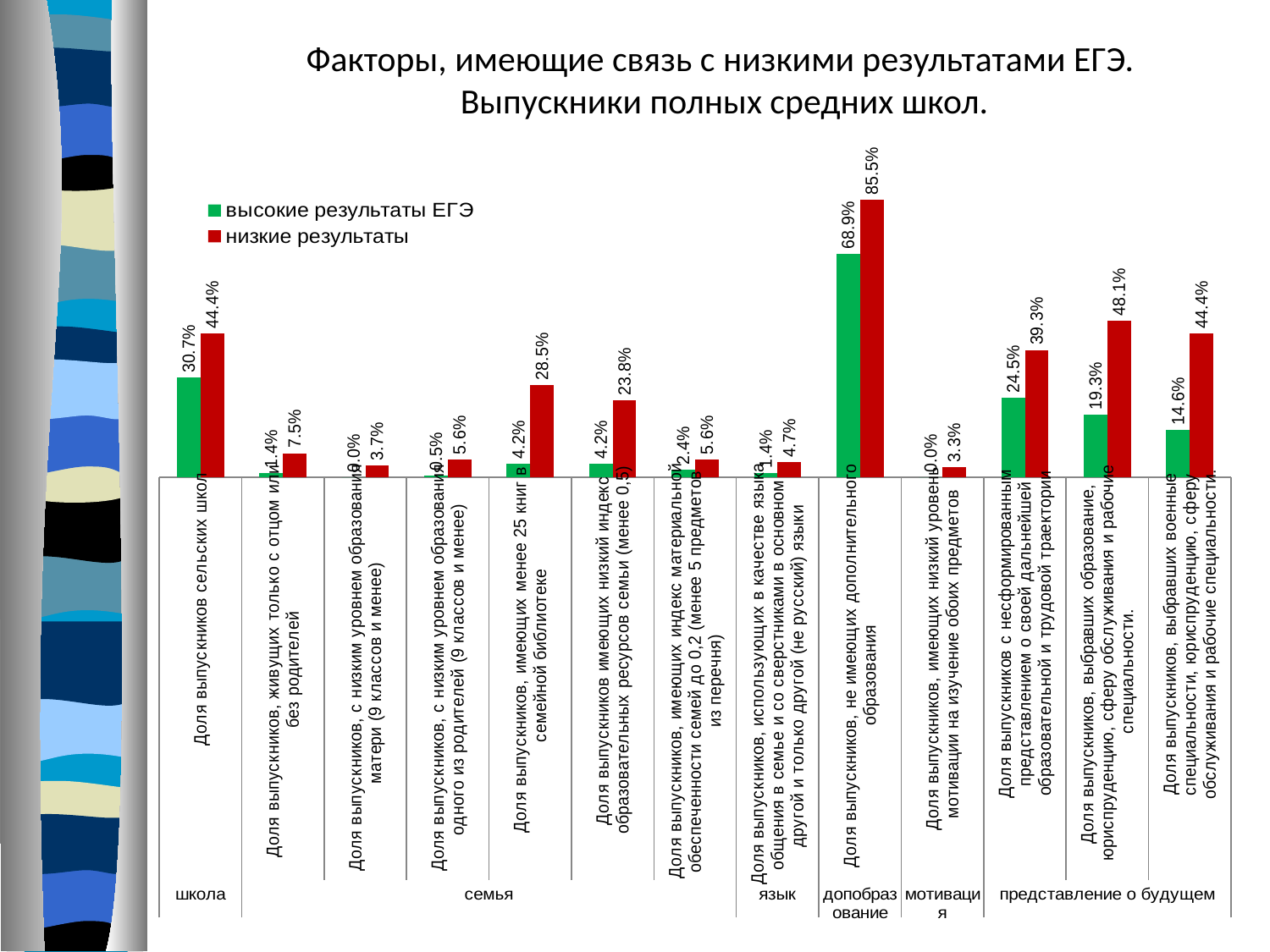
How many series does the legend list? 2 Which is larger for 'Доля выпускников, выбравших образование, юриспруденцию, сферу обслуживания и рабочие специальности': 'высокие результаты ЕГЭ' or 'низкие результаты'? низкие результаты Which category has the highest value for 'низкие результаты'? Доля выпускников, не имеющих дополнительного образования What is the difference between 'низкие результаты' and 'высокие результаты ЕГЭ' for 'Доля выпускников с несформированным представлением о своей дальнейшей образовательной и трудовой траектории'? 14.8% What is the value of 'низкие результаты' for 'Доля выпускников, имеющих менее 25 книг в семейной библиотеке'? 28.5% What is the value of 'высокие результаты ЕГЭ' for 'Доля выпускников, имеющих низкий уровень мотивации на изучение обоих предметов'? 0.0% What kind of chart is shown on the slide? bar chart What colour are the bars for 'низкие результаты'? red How many categories are plotted on the chart? 13 What is the value of 'высокие результаты ЕГЭ' for 'Доля выпускников, не имеющих дополнительного образования'? 68.9% What is the value of 'низкие результаты' for 'Доля выпускников сельских школ'? 44.4% What is the difference between 'низкие результаты' and 'высокие результаты ЕГЭ' for 'Доля выпускников, не имеющих дополнительного образования'? 16.6%